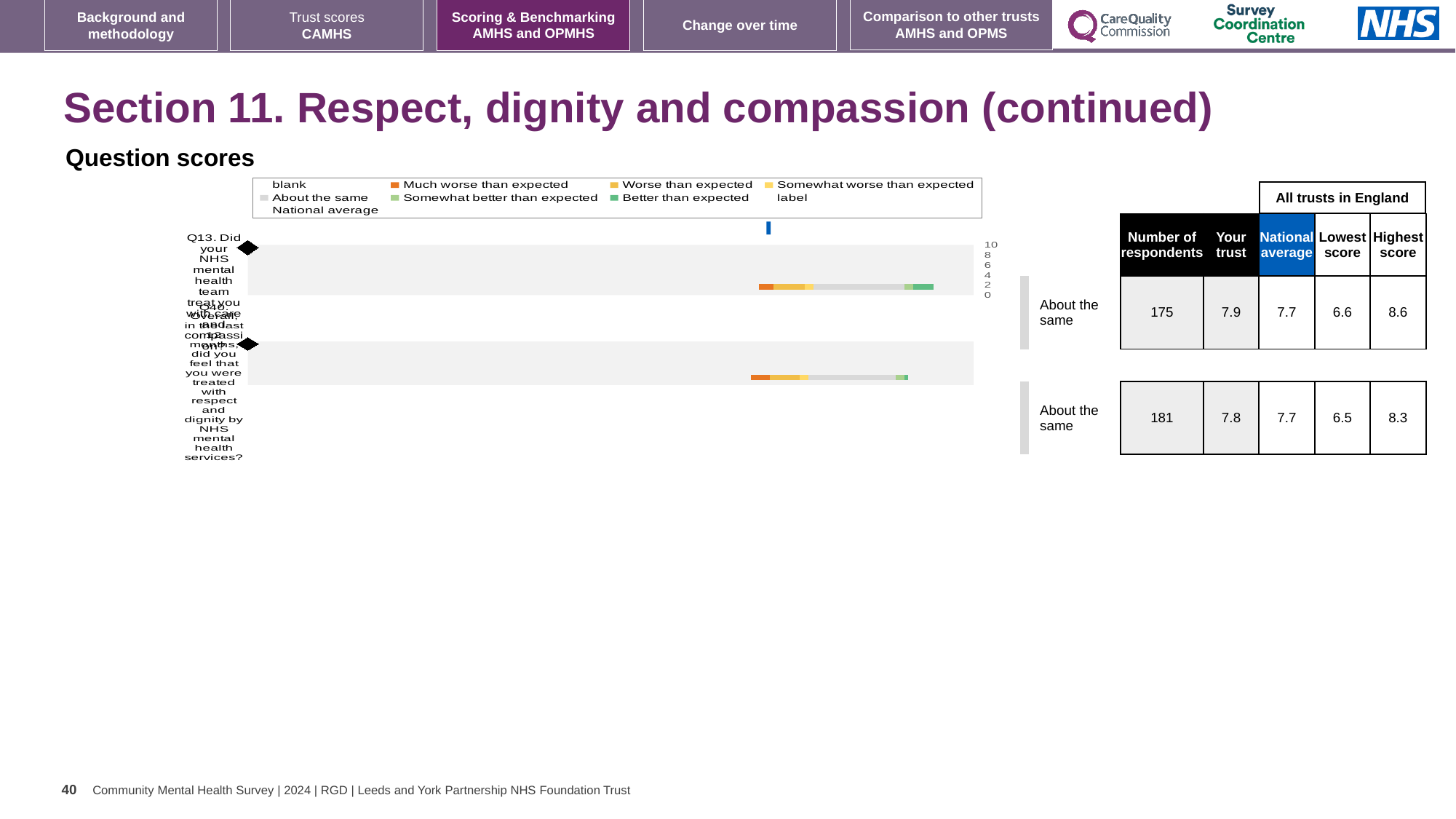
What benchmark category is shown for both Q13 and Q10? About the same How many entries does the legend of the question scores chart list? 9 What is the 'Your trust' score for Q10 (treated with respect and dignity by NHS mental health services)? 7.8 Which question has the higher 'Highest score' across all trusts in England? Q13 What kind of chart is used to show the question scores on this slide? Bar chart What is the difference between the highest score and the lowest score for Q13? 2.0 Which question has the higher 'Your trust' score, Q13 or Q10? Q13 What is the 'Your trust' score for Q13 (Did your NHS mental health team treat you with care and compassion?)? 7.9 What is the national average score for Q10? 7.7 How many respondents answered Q13? 175 How many respondents answered Q10? 181 How many questions are plotted in the question scores chart? 2